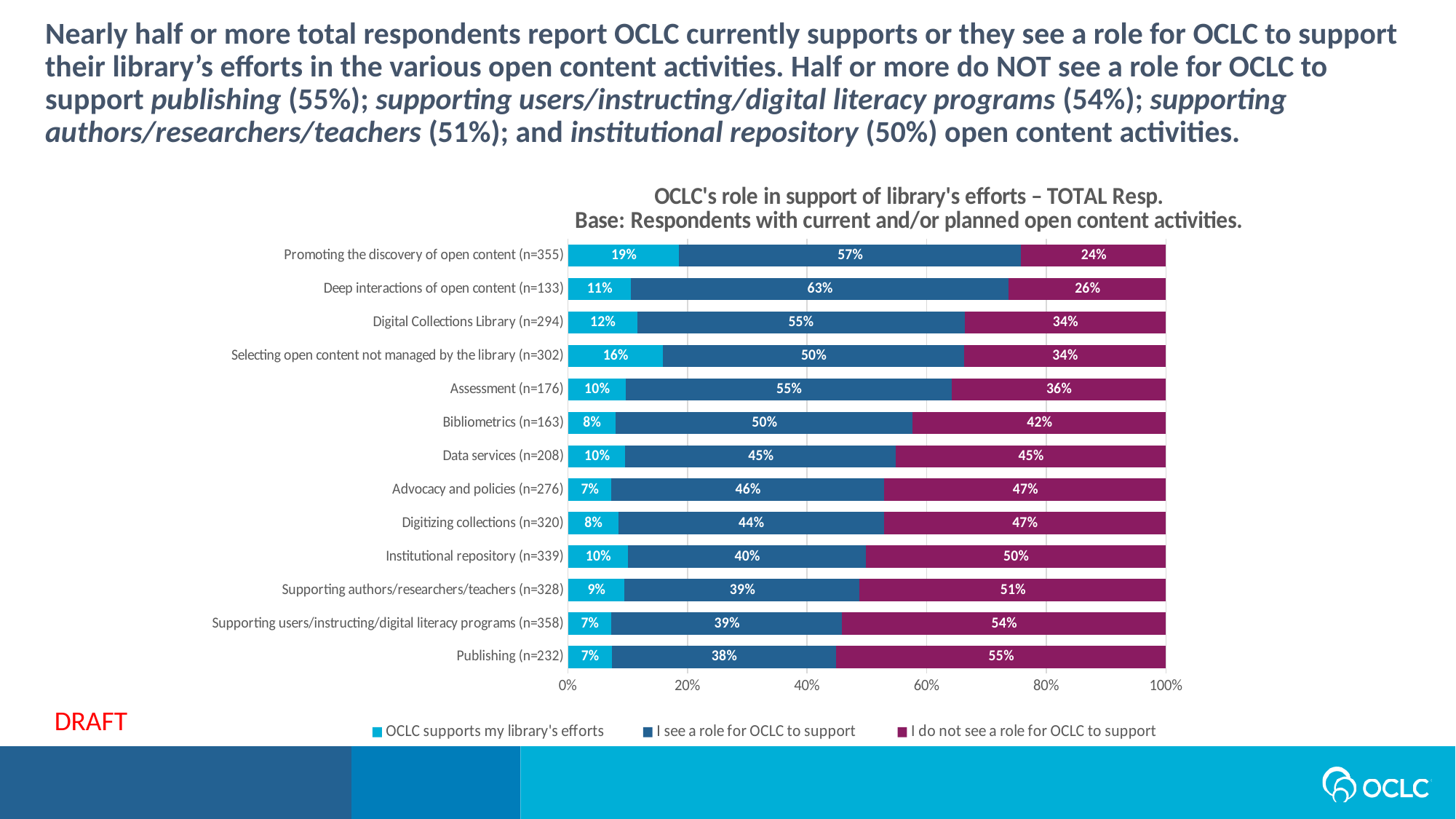
What percentage of respondents for Deep interactions of open content (n=133) said they see a role for OCLC to support? 63% How many categories are shown on the chart? 13 What percentage of respondents for Publishing (n=232) said they do not see a role for OCLC to support? 55% Which category has the lowest value for 'I do not see a role for OCLC to support'? Promoting the discovery of open content (n=355) Which is larger: the 'OCLC supports my library's efforts' value for Selecting open content not managed by the library (n=302) or for Digital Collections Library (n=294)? Selecting open content not managed by the library (n=302) What is the total of the three segments for Bibliometrics (n=163)? 100% How many series does the legend list? 3 Which category has the highest value for 'I see a role for OCLC to support'? Deep interactions of open content (n=133) Which legend entry is shown in the magenta/purple colour? I do not see a role for OCLC to support What is the difference between the 'I do not see a role for OCLC to support' values for Publishing (n=232) and Institutional repository (n=339)? 5% What percentage of respondents for Promoting the discovery of open content (n=355) said OCLC supports my library's efforts? 19% What kind of chart is shown on the slide? Stacked bar chart